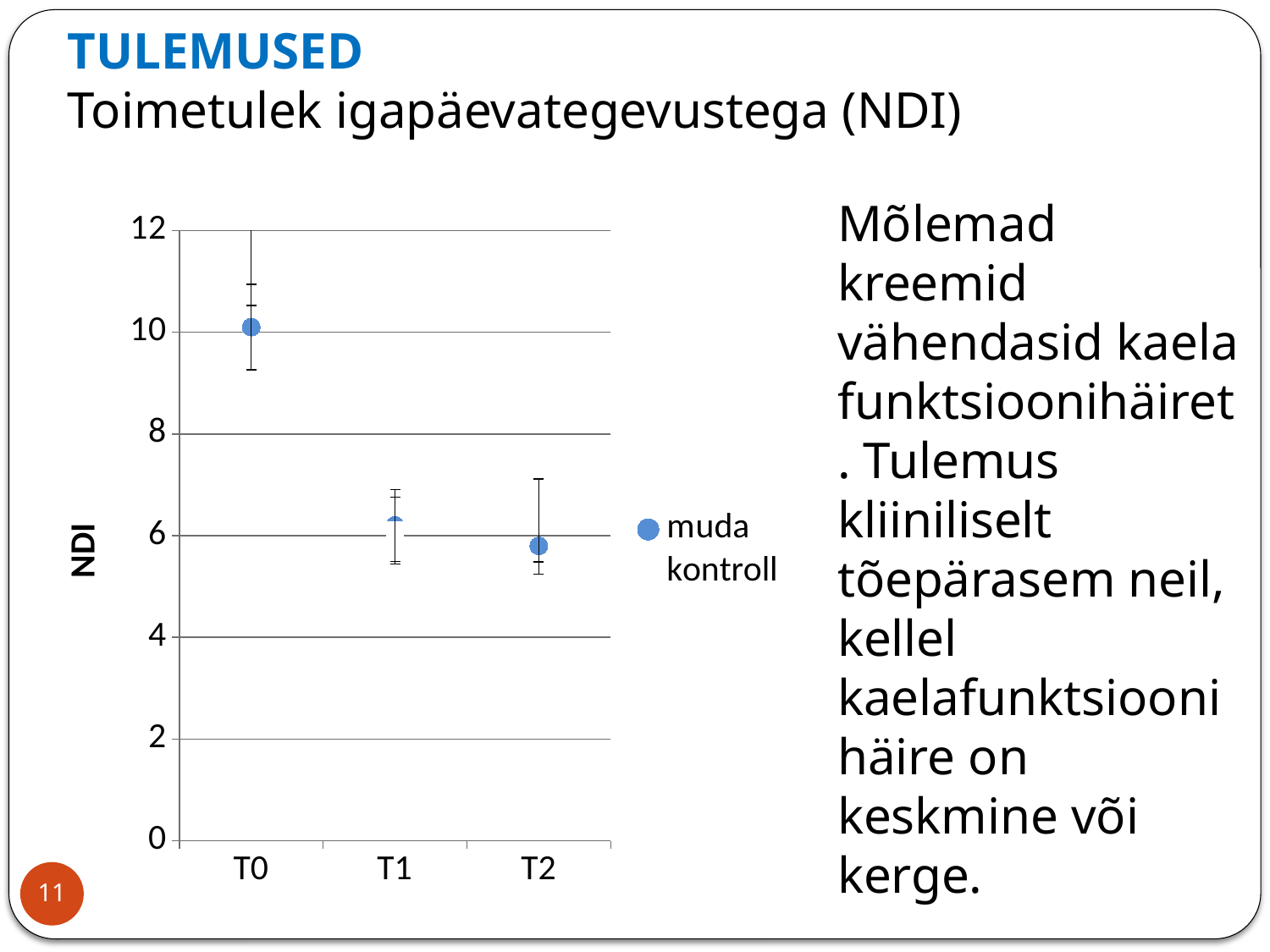
What is the label of the vertical axis of the chart? NDI Which has a larger NDI value, T0 or T1? T0 Do the NDI values rise or fall from T0 to T2? fall What are the two entries listed in the chart legend? muda, kontroll Is the NDI value at T2 greater or less than 8? less Is the NDI value at T2 greater or less than 4? greater How many series does the chart legend list? 2 Is the NDI value at T0 greater or less than 8? greater How many time points are shown on the x axis of the chart? 3 Which time point has the highest NDI value in the chart? T0 What kind of chart is shown on the slide? scatter chart